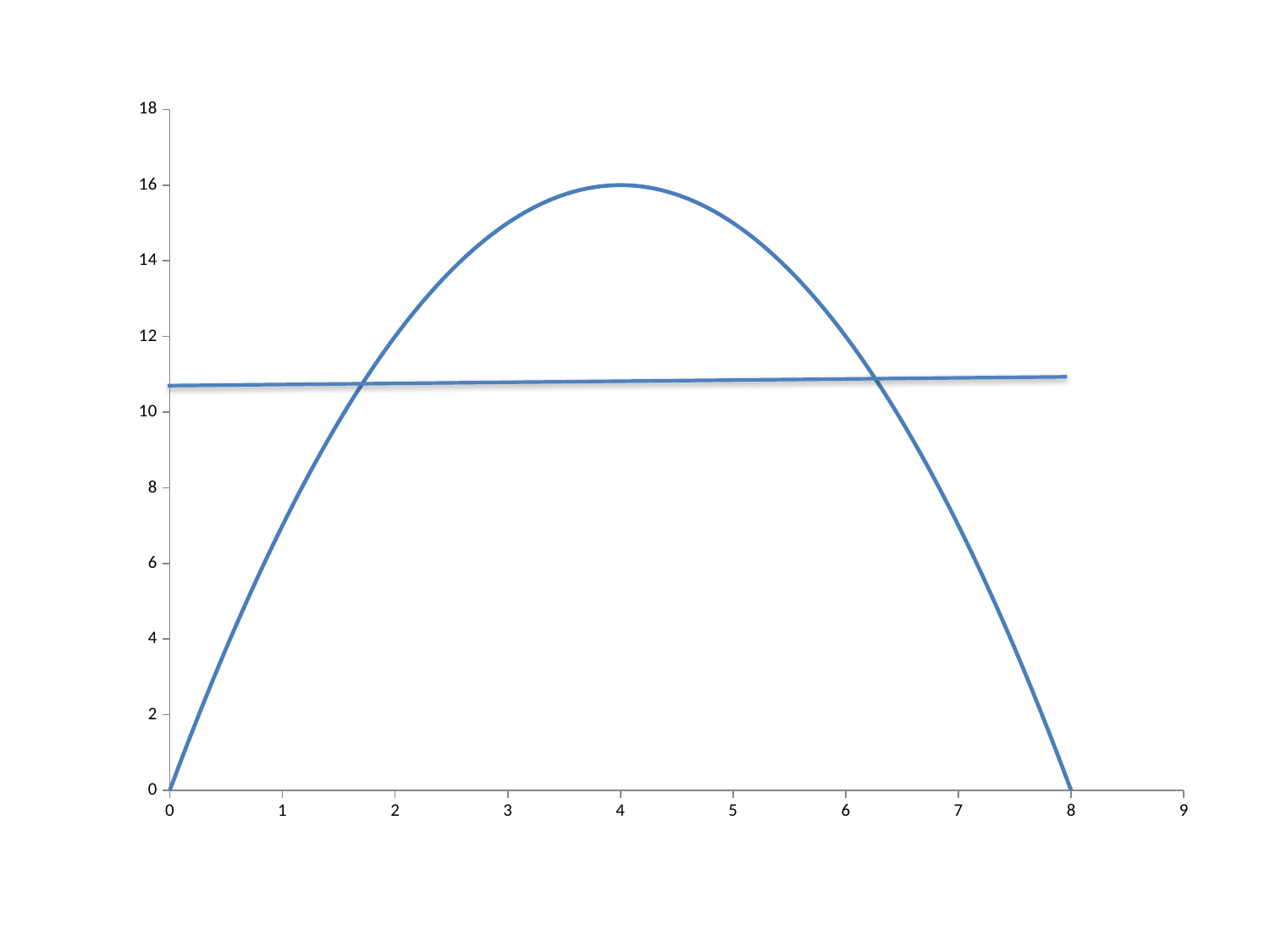
How many lines are plotted on the chart? 2 What is the highest value shown on the vertical axis? 18 What kind of chart is shown on the slide? line chart Is the value of the curved line at x = 2 greater or less than 10? greater Is the value of the curved line at x = 1 greater or less than 8? less Does the curved line rise or fall between x = 4 and x = 8? fall Is the value of the curved line at x = 7 greater or less than 8? less What is the value of the curved line at x = 0? 0 What is the highest value reached by the curved line? 16 At what x value does the curved line reach its highest point? 4 What is the value of the curved line at x = 8? 0